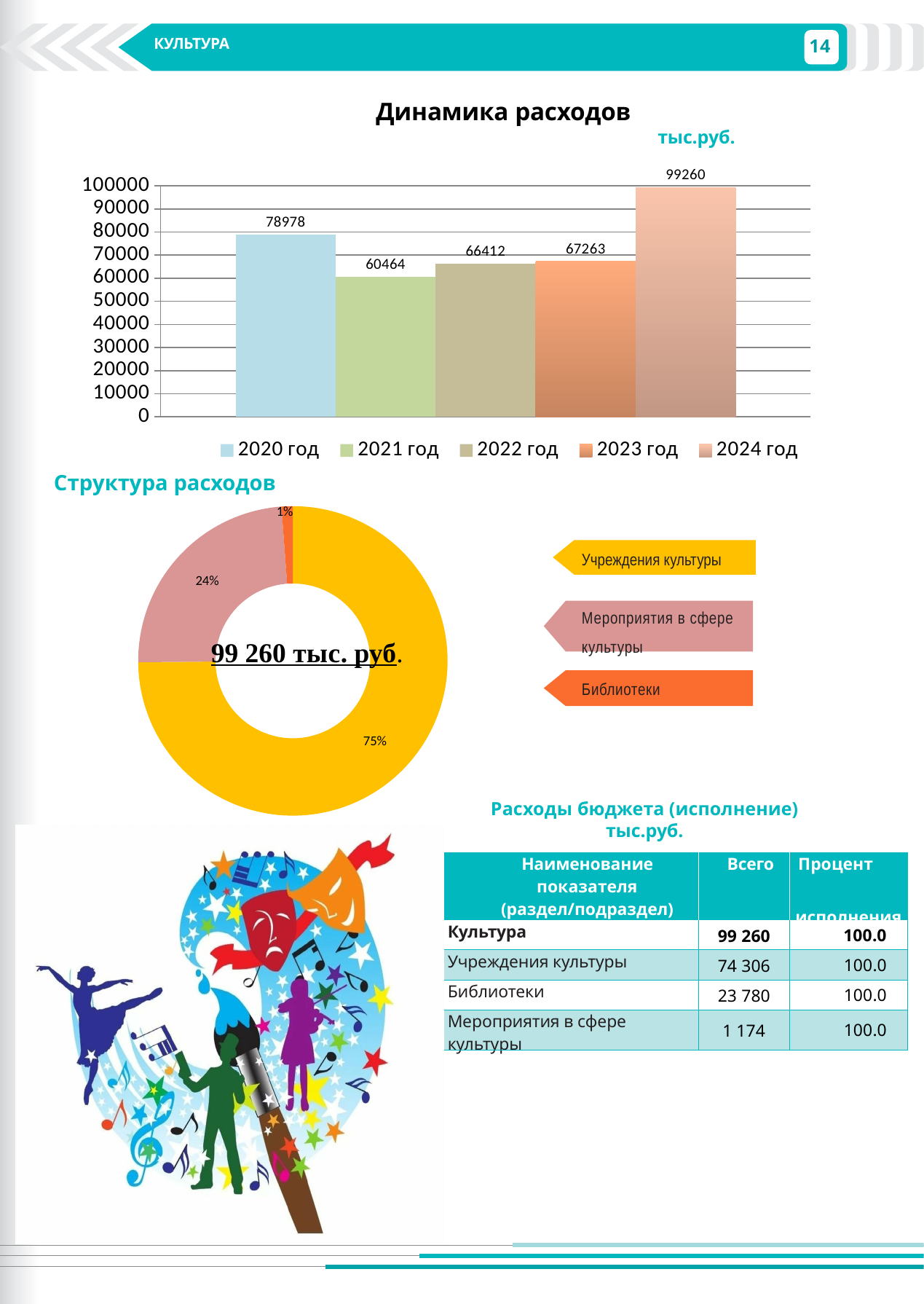
In the 'Динамика расходов' chart, which year has the lowest value? 2021 год In the 'Структура расходов' chart, which category has the largest slice? Учреждения культуры In the 'Динамика расходов' chart, how many years are plotted? 5 What kind of chart is 'Динамика расходов'? bar chart In the 'Динамика расходов' chart, what is the value for 2024 год? 99260 In the 'Динамика расходов' chart, what is the value for 2021 год? 60464 In the 'Динамика расходов' chart, which year has the highest value? 2024 год In the 'Динамика расходов' chart, how many entries does the legend list? 5 In the 'Динамика расходов' chart, which is larger: the value for 2022 год or 2023 год? 2023 год In the 'Структура расходов' chart, what share is shown for Учреждения культуры? 75% What total value is printed in the centre of the 'Структура расходов' donut chart? 99 260 тыс. руб. In the 'Динамика расходов' chart, what is the difference between the values for 2024 год and 2020 год? 20282